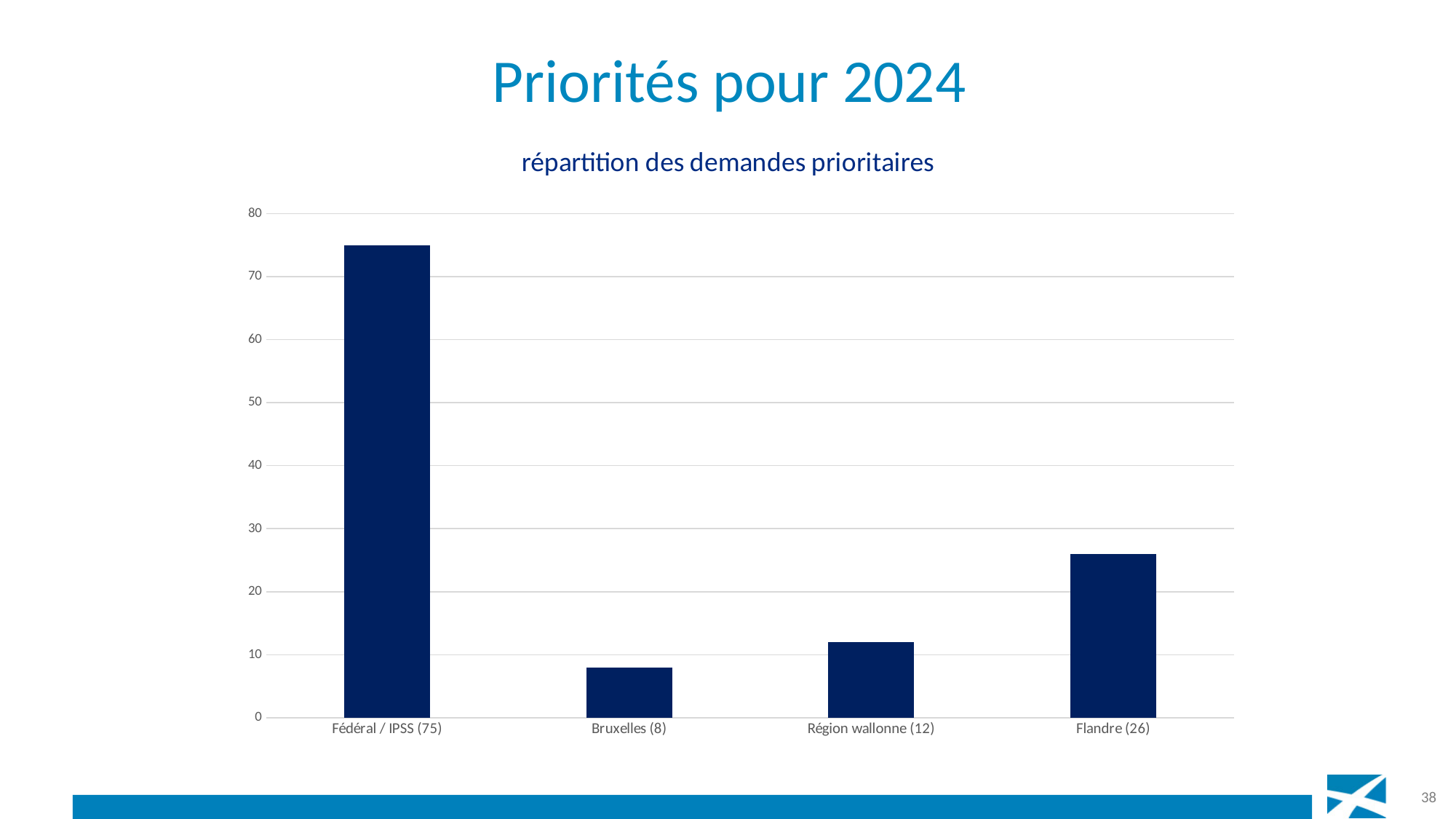
What is the difference between the values for Flandre and Région wallonne? 14 What kind of chart is shown on the slide? bar chart Which category has the highest value? Fédéral / IPSS Which category has the lowest value? Bruxelles What is the value for Bruxelles? 8 What is the value for Région wallonne? 12 What is the value for Fédéral / IPSS? 75 Which is larger, the value for Région wallonne or the value for Bruxelles? Région wallonne What is the difference between the values for Fédéral / IPSS and Flandre? 49 Is the value for Flandre greater or less than 30? less How many categories are shown in the chart? 4 What is the value for Flandre? 26